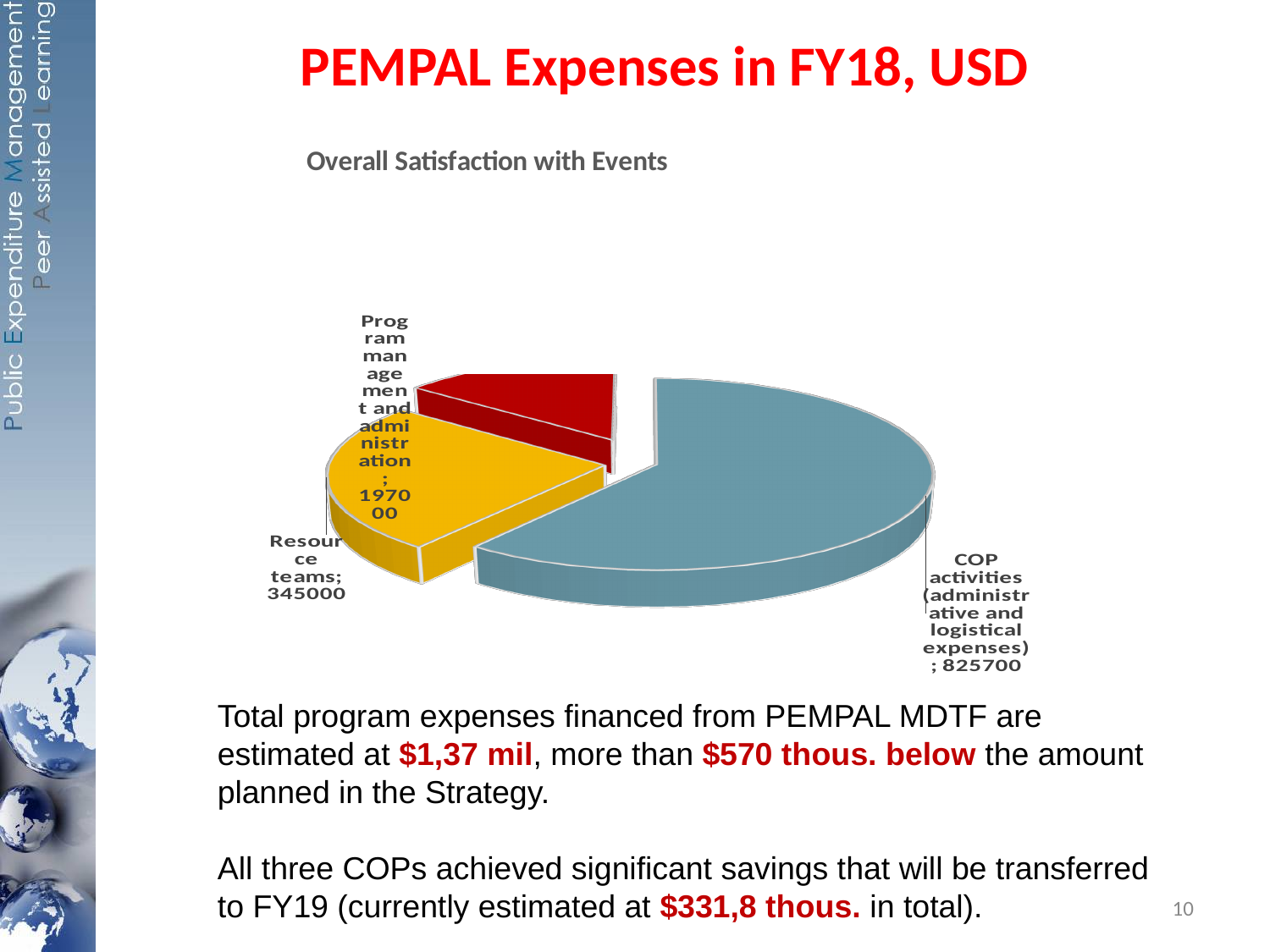
What is the difference between the values for Resource teams and Program management and administration? 148000 What is the total of all three slices in the pie chart? 1367700 How many categories are shown in the pie chart? 3 What is the value for Program management and administration? 197000 Which category has the smallest slice of the pie? Program management and administration Which category has the largest slice of the pie? COP activities (administrative and logistical expenses) What is the difference between the values for COP activities and Resource teams? 480700 What kind of chart is shown on the slide? Pie chart Which is larger, the value for Resource teams or the value for Program management and administration? Resource teams What is the title printed above the pie chart? Overall Satisfaction with Events What is the value for Resource teams? 345000 What is the value for COP activities (administrative and logistical expenses)? 825700